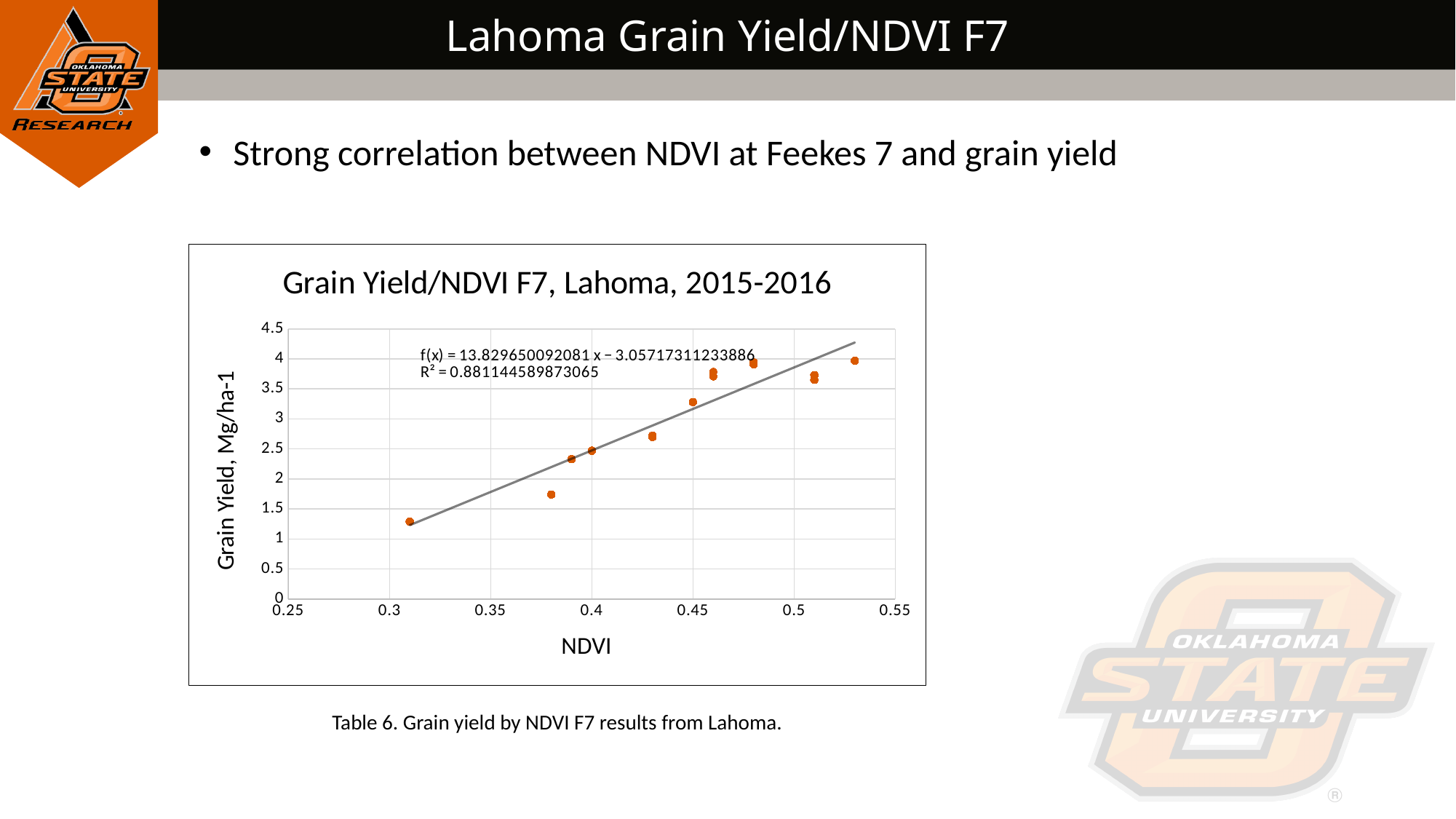
What R² value is printed on the chart? 0.881144589873065 Does grain yield rise or fall as NDVI increases along the x axis? Rise Is the grain yield for the point at NDVI 0.43 greater or less than 2.5? greater What is the slope of the fitted line equation printed on the chart? 13.829650092081 What is the label of the y axis of the chart? Grain Yield, Mg/ha-1 Is the grain yield for the point at NDVI 0.31 greater or less than 1.5? less What is the title of the chart? Grain Yield/NDVI F7, Lahoma, 2015-2016 Is the grain yield for the point at NDVI 0.53 greater or less than 3.5? greater Which has the higher grain yield: the point at NDVI 0.31 or the point at NDVI 0.53? The point at NDVI 0.53 What kind of chart is shown on the slide? Scatter chart